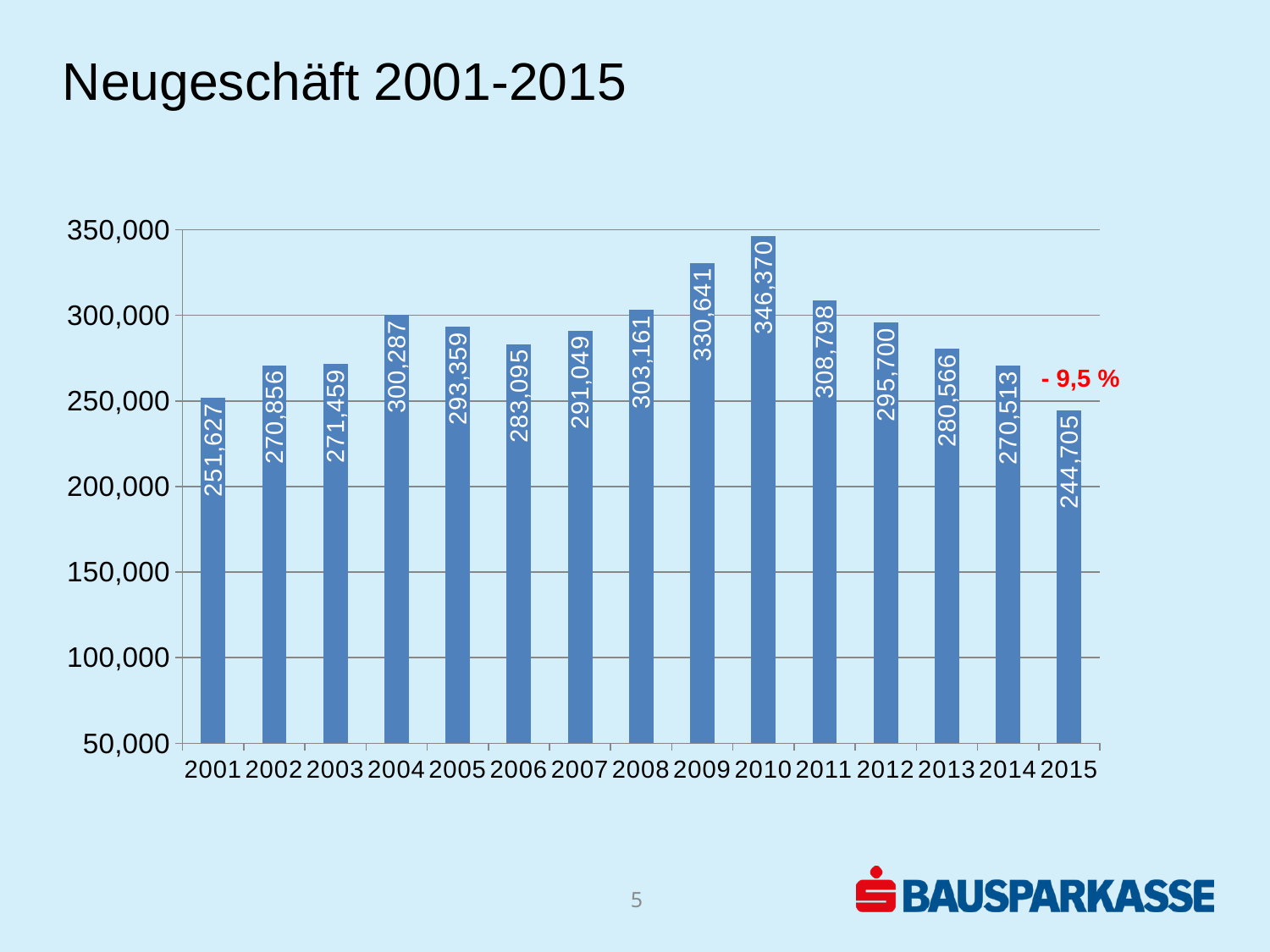
What is the value for 2010? 346,370 Which year has the highest value? 2010 How many years are shown in the chart? 15 What is the difference between the values for 2010 and 2009? 15,729 Which is larger, the value for 2004 or the value for 2008? 2008 What kind of chart is shown on the slide? Bar chart Is the value for 2009 greater or less than 300,000? greater What is the difference between the values for 2014 and 2015? 25,808 Do the values rise or fall from 2010 to 2015? Fall Which year has the lowest value? 2015 What is the value for 2004? 300,287 What is the value for 2015? 244,705